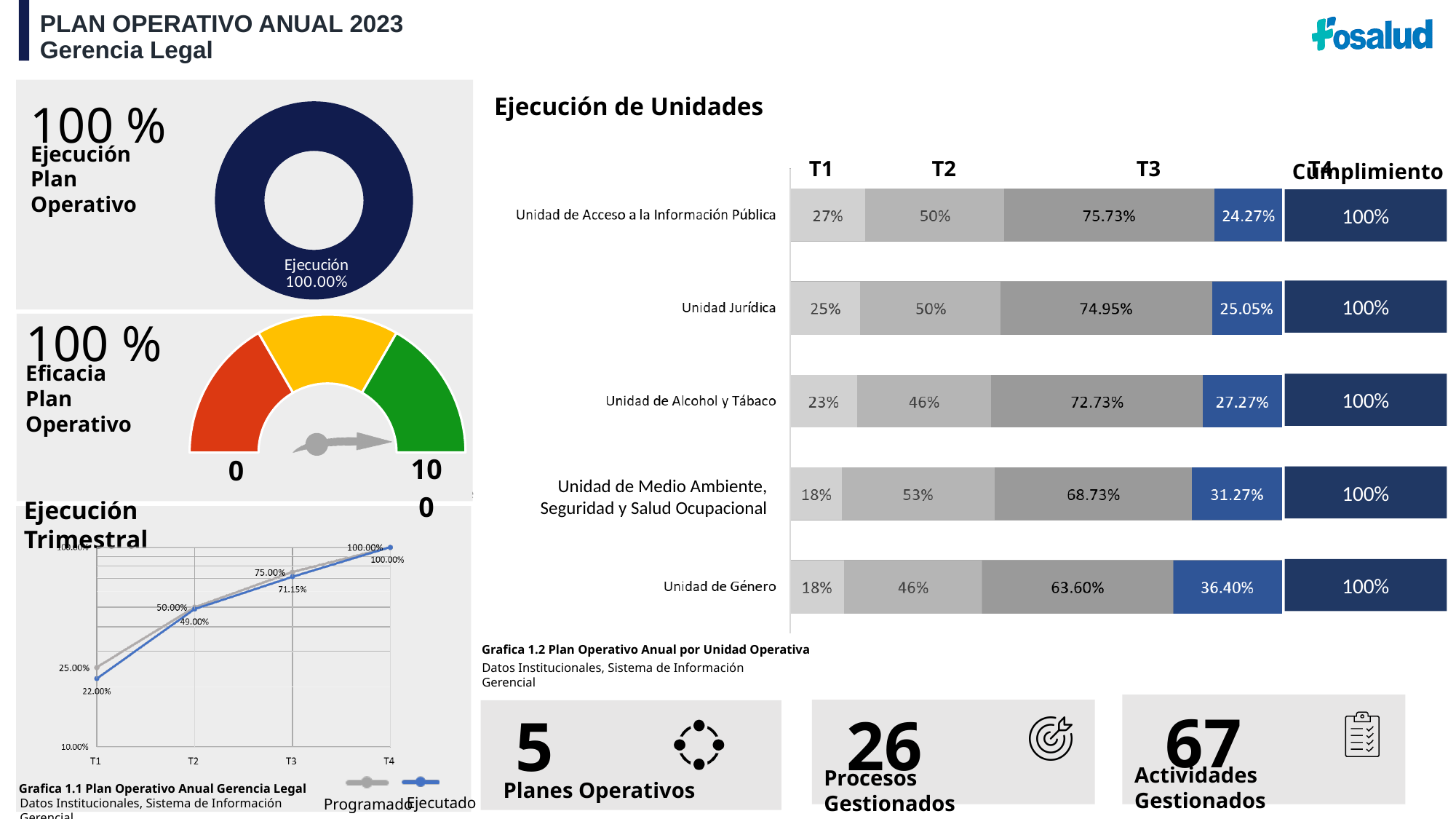
In the 'Ejecución de Unidades' chart, which unit has the highest T4 value? Unidad de Género How many series does the legend of the 'Ejecución Trimestral' line chart list? 2 In the 'Ejecución de Unidades' chart, what is the difference between the T4 value for Unidad de Género and the T4 value for Unidad de Acceso a la Información Pública? 12.13 percentage points In the 'Ejecución de Unidades' chart, what is the T4 value for Unidad Jurídica? 25.05% In the 'Ejecución Trimestral' line chart, do the values rise or fall from T1 to T4? Rise What kind of chart is the 'Ejecución de Unidades' chart? Bar chart In the 'Ejecución de Unidades' chart, which unit has the lowest T3 value? Unidad de Género How many units are listed in the 'Ejecución de Unidades' chart? 5 In the 'Ejecución de Unidades' chart, what is the T3 value for Unidad de Género? 63.60% In the 'Ejecución de Unidades' chart, which has the larger T2 value: Unidad de Medio Ambiente, Seguridad y Salud Ocupacional or Unidad de Alcohol y Tábaco? Unidad de Medio Ambiente, Seguridad y Salud Ocupacional In the 'Ejecución Trimestral' line chart, what is the difference between the Programado and Ejecutado values at T1? 3.00 percentage points In the 'Ejecución Trimestral' line chart, what is the Ejecutado value at T3? 71.15%